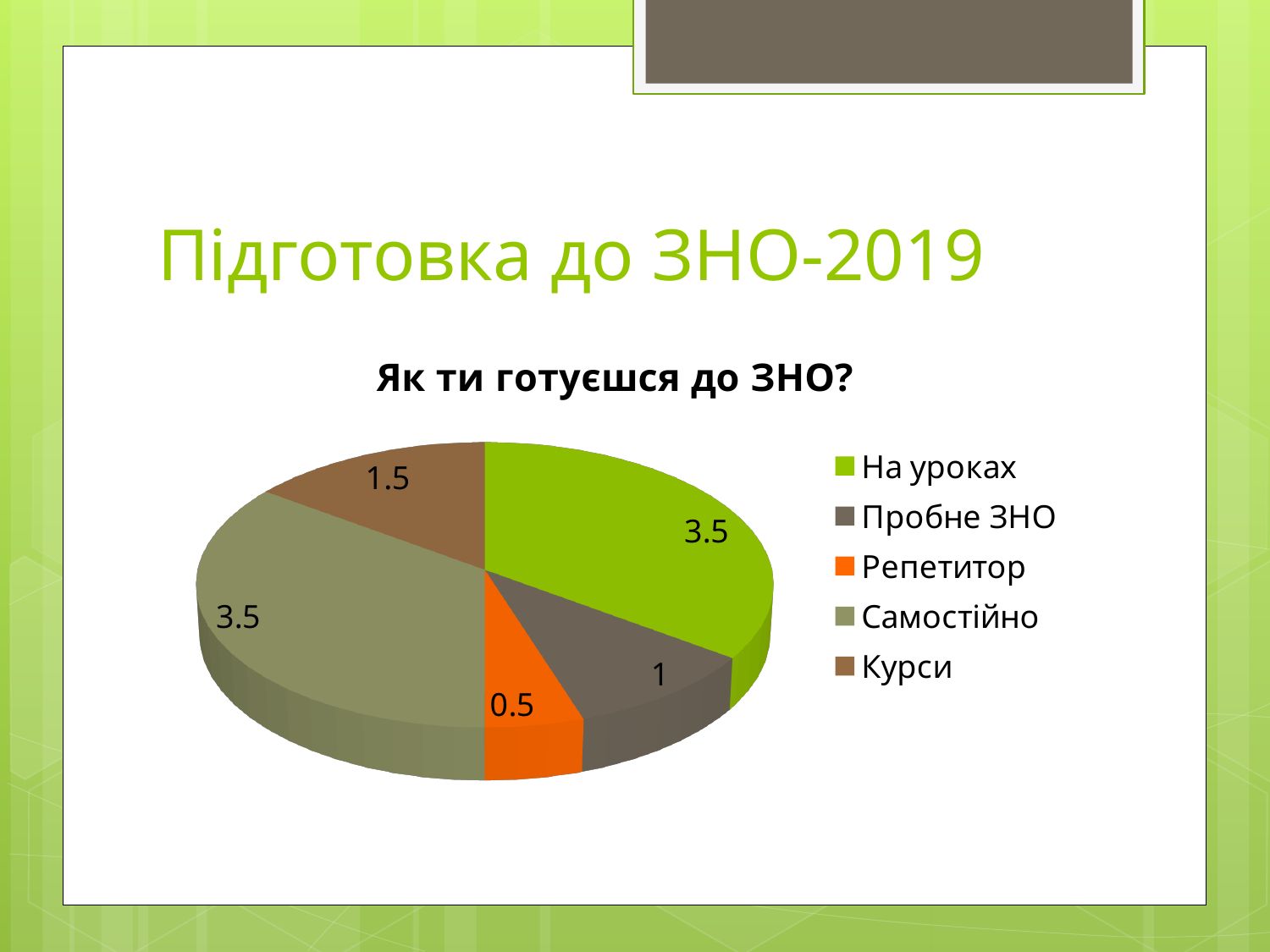
What is the value for Курси? 1.5 What type of chart is shown on the slide? pie chart What is the value for Репетитор? 0.5 What share of the pie does На уроках represent? 35% Which is larger, the value for Пробне ЗНО or the value for Курси? Курси What is the value for Пробне ЗНО? 1 What is the difference between the values for Самостійно and Курси? 2 What colour is the slice for Репетитор? orange What is the value for На уроках? 3.5 How many categories does the legend list? 5 Which category has the smallest slice? Репетитор What is the title of the chart? Як ти готуєшся до ЗНО?